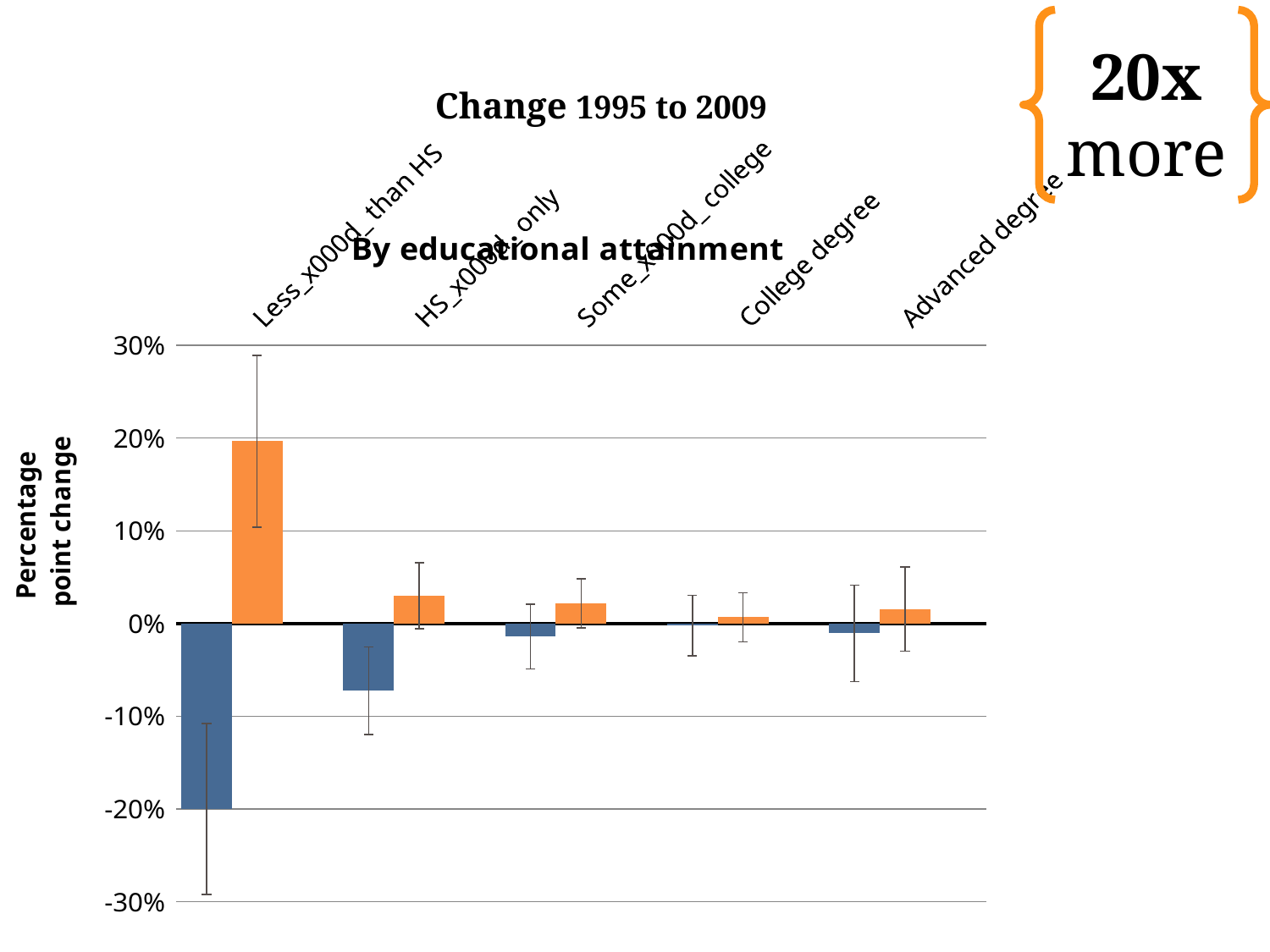
Which has the more negative blue bar, HS only or Some college? HS only Is the blue bar for Less than HS greater or less than -10%? less Is the orange bar for HS only greater or less than 10%? less What is the label on the vertical axis? Percentage point change What is the title of the chart? By educational attainment Is the blue bar for HS only greater or less than -10%? greater Which category has the tallest orange bar? Less than HS Which has the larger orange bar, Less than HS or HS only? Less than HS How many educational attainment categories are shown on the x axis? 5 What kind of chart is shown on the slide? bar chart Which category has the lowest (most negative) blue bar? Less than HS